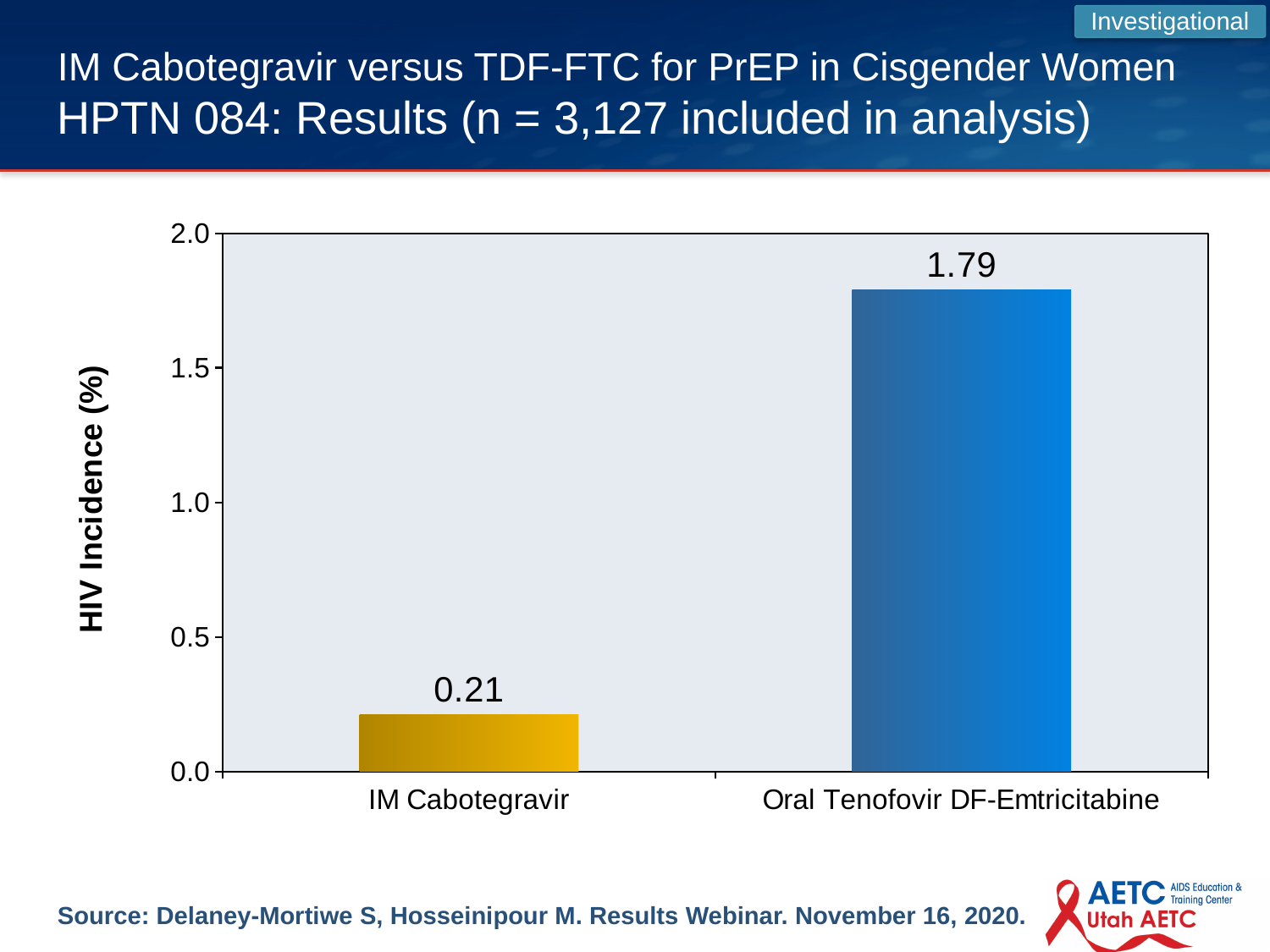
How many categories are shown on the chart? 2 What kind of chart is shown on the slide? bar chart Which has a larger HIV incidence, IM Cabotegravir or Oral Tenofovir DF-Emtricitabine? Oral Tenofovir DF-Emtricitabine What colour is the bar for IM Cabotegravir? yellow Is the value for IM Cabotegravir greater or less than 0.5? less What is the HIV incidence (%) for IM Cabotegravir? 0.21 Is the value for Oral Tenofovir DF-Emtricitabine greater or less than 1.5? greater Which category has the lowest HIV incidence? IM Cabotegravir What is the difference in HIV incidence (%) between Oral Tenofovir DF-Emtricitabine and IM Cabotegravir? 1.58 What is the label of the y axis? HIV Incidence (%) Which category has the highest HIV incidence? Oral Tenofovir DF-Emtricitabine What is the HIV incidence (%) for Oral Tenofovir DF-Emtricitabine? 1.79